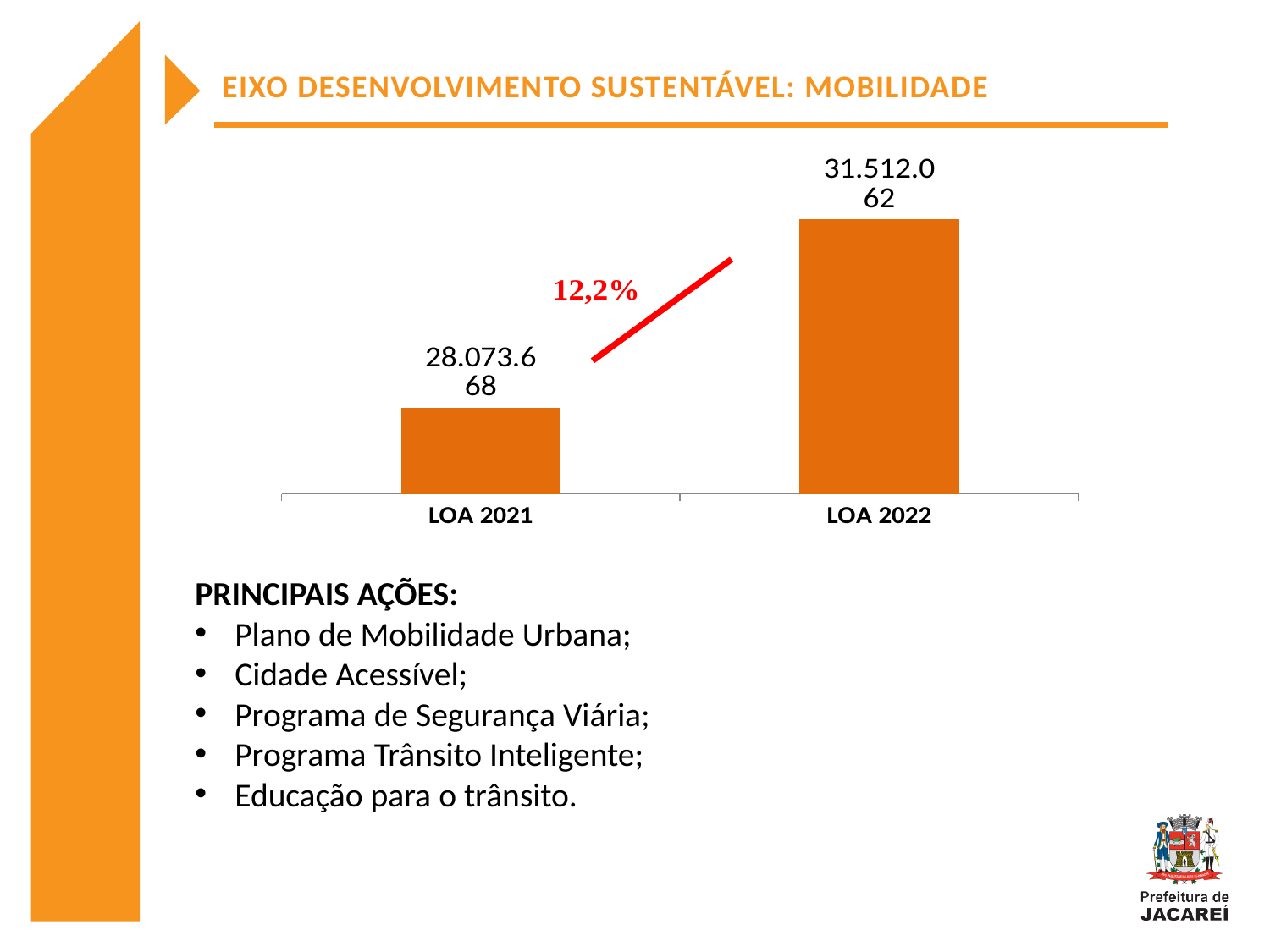
Which category has the highest value? LOA 2022 What is the difference between the LOA 2022 and LOA 2021 values? 3.438.394 Which category has the lowest value? LOA 2021 What is the value shown for LOA 2022? 31.512.062 What colour are the bars in the chart? Orange Which is larger, the value for LOA 2021 or LOA 2022? LOA 2022 How many bars are plotted in the chart? 2 What percentage change is annotated in red between the two bars? 12,2% What kind of chart is shown on the slide? Bar chart What is the value shown for LOA 2021? 28.073.668 Do the values rise or fall from LOA 2021 to LOA 2022? Rise